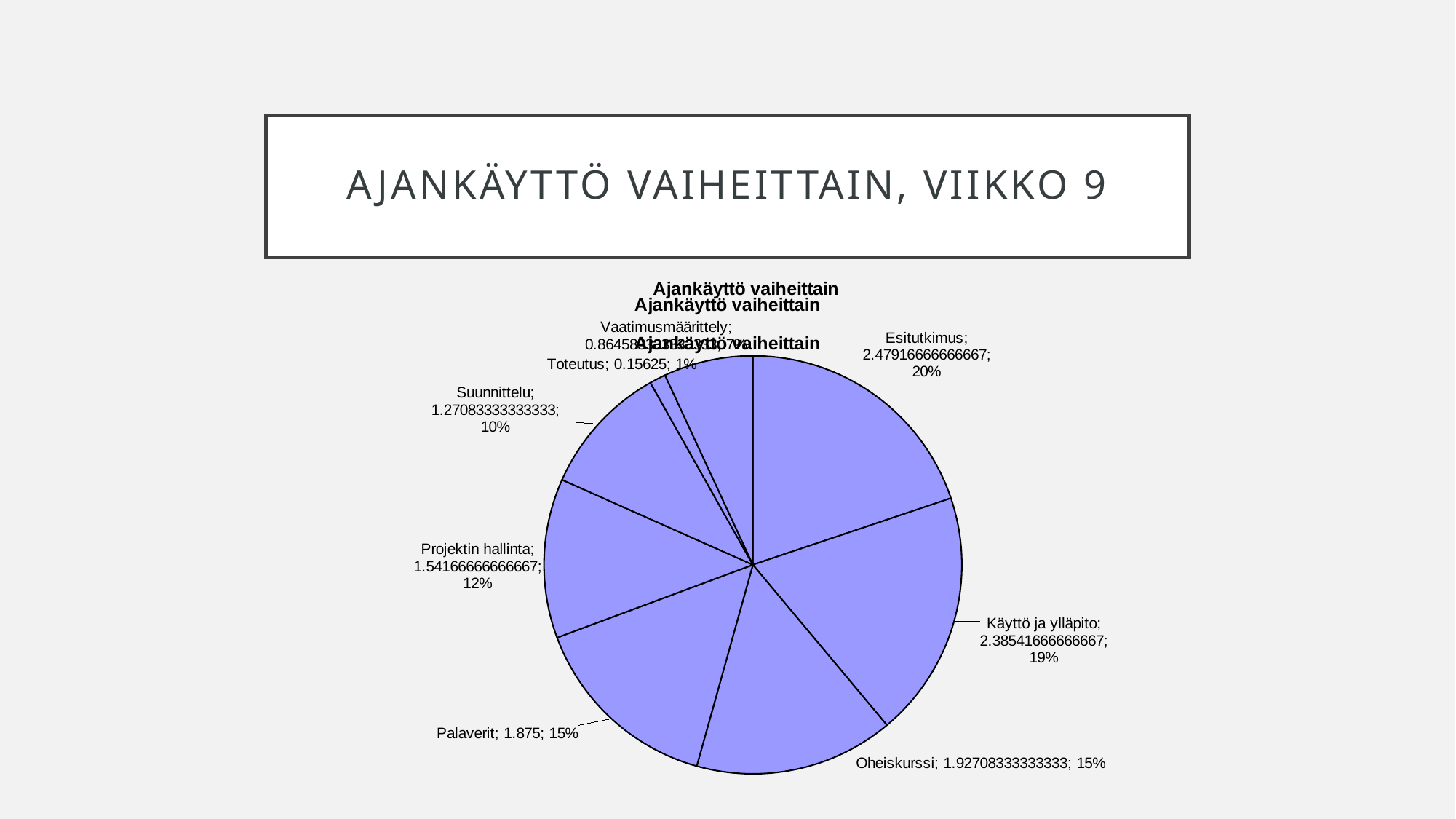
What is the value shown for Esitutkimus? 2.47916666666667 What share of the pie does Suunnittelu represent? 10% What is the value shown for Palaverit? 1.875 What is the value shown for Projektin hallinta? 1.54166666666667 Which category has the largest slice of the pie? Esitutkimus What is the title of the pie chart? Ajankäyttö vaiheittain What share of the pie does Käyttö ja ylläpito represent? 19% What kind of chart is shown on the slide? Pie chart What is the value shown for Toteutus? 0.15625 Which is larger, the value for Oheiskurssi or the value for Palaverit? Oheiskurssi Which category has the smallest slice of the pie? Toteutus How many slices does the pie chart have? 8